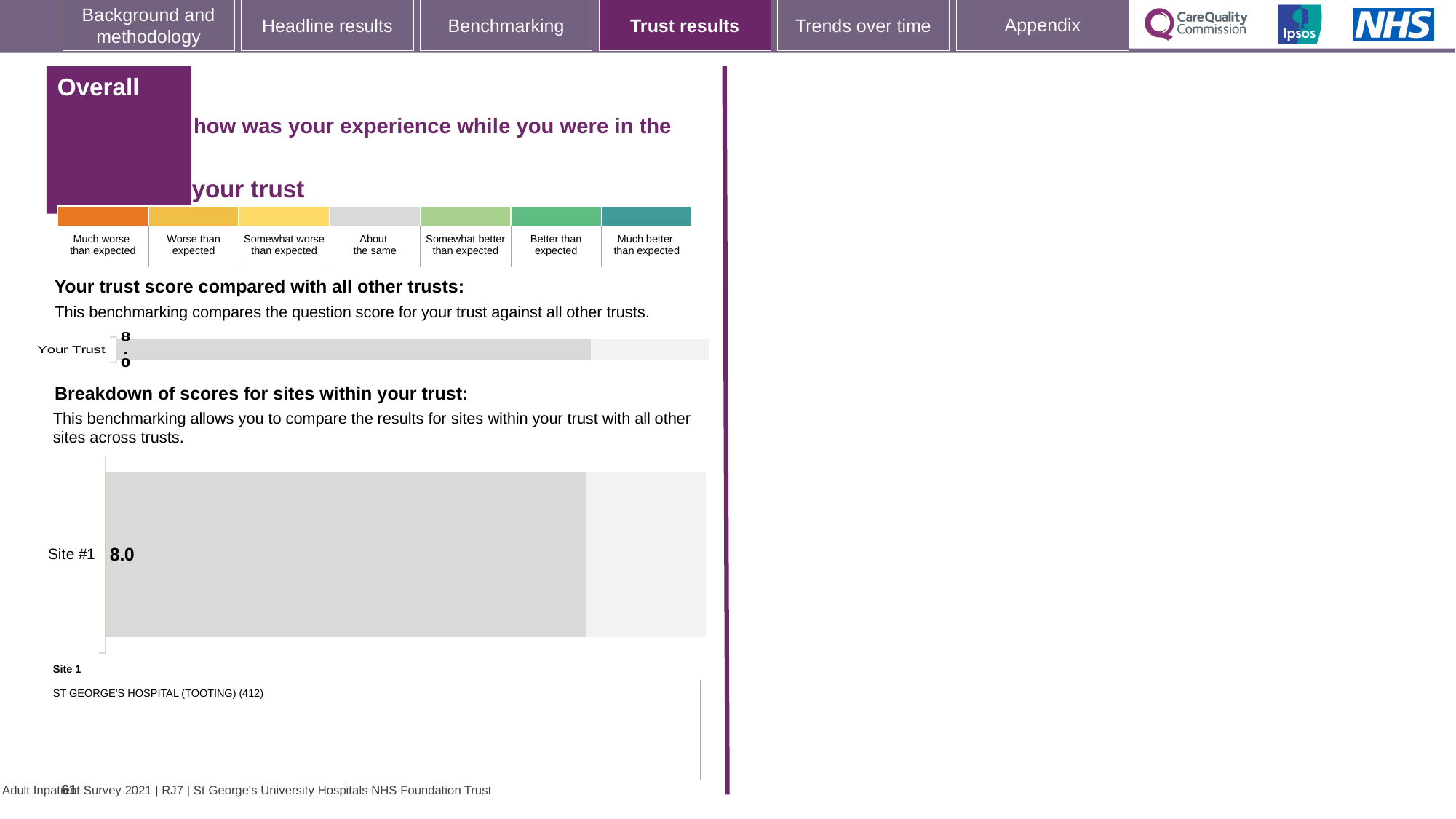
What kind of chart is the 'Breakdown of scores for sites within your trust' chart? bar chart What kind of chart is the 'Your trust score compared with all other trusts' chart? bar chart In the 'Your trust score compared with all other trusts' chart, what is the score for Your Trust? 8.0 In the 'Breakdown of scores for sites within your trust' chart, what is the score for Site #1? 8.0 How many bars are shown in the 'Your trust score compared with all other trusts' chart? 1 In the 'Breakdown of scores for sites within your trust' chart, what is the label of the plotted bar? Site #1 How many sites are plotted in the 'Breakdown of scores for sites within your trust' chart? 1 According to the key below the site breakdown chart, which hospital is Site 1? ST GEORGE'S HOSPITAL (TOOTING) What is the difference between the Site #1 score in the site breakdown chart and the Your Trust score in the trust comparison chart? 0.0